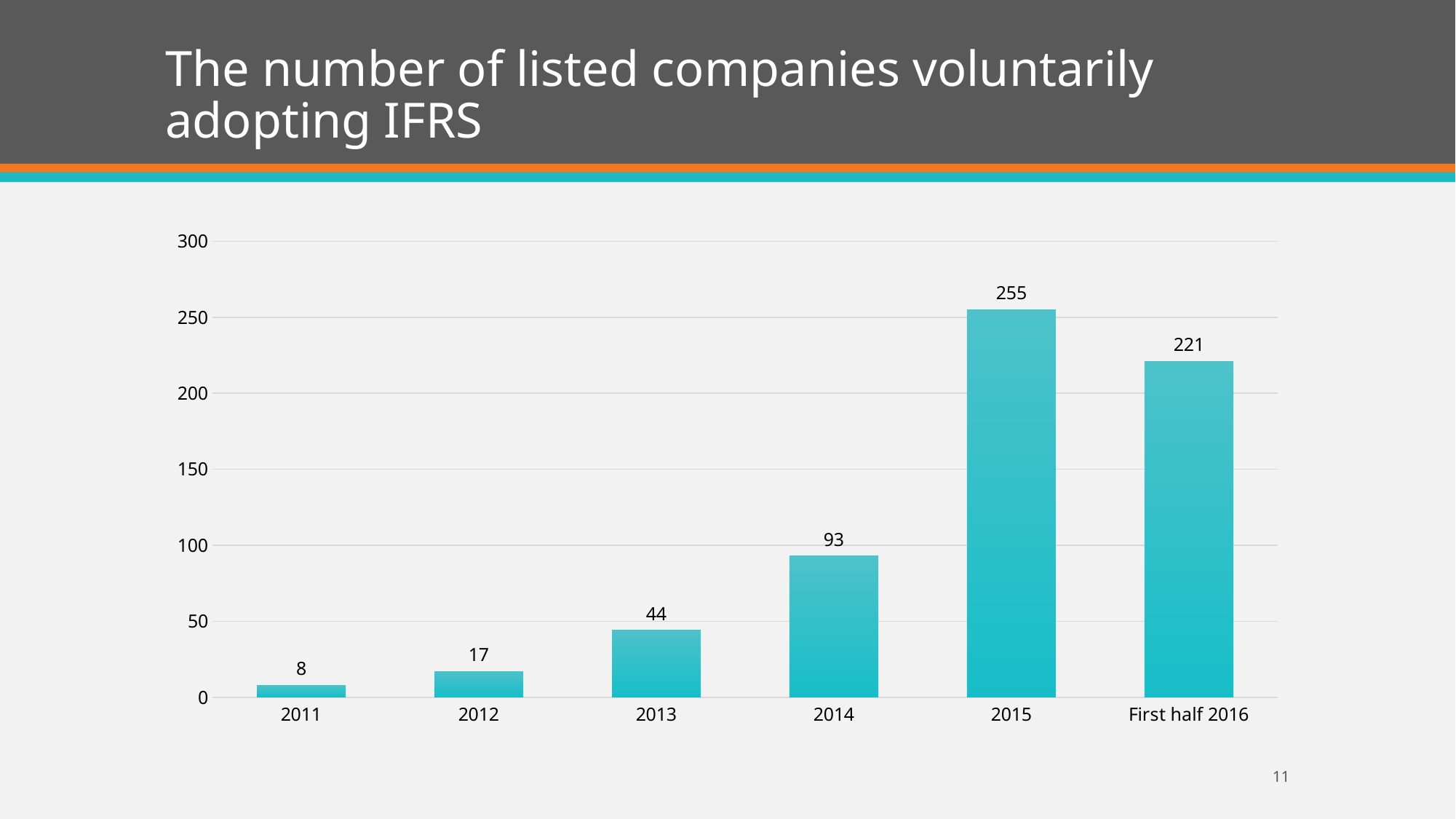
Do the values rise or fall from 2011 to 2015? rise Is the value for 2015 greater or less than 250? greater What is the value for 2014? 93 Which category has the lowest value? 2011 How many categories are shown on the x axis? 6 What is the difference between the values for 2013 and 2012? 27 Which is larger, the value for 2013 or the value for 2014? 2014 What kind of chart is shown on the slide? bar chart What is the value for 2011? 8 What is the value for First half 2016? 221 Which category has the highest value? 2015 What is the difference between the values for 2015 and First half 2016? 34